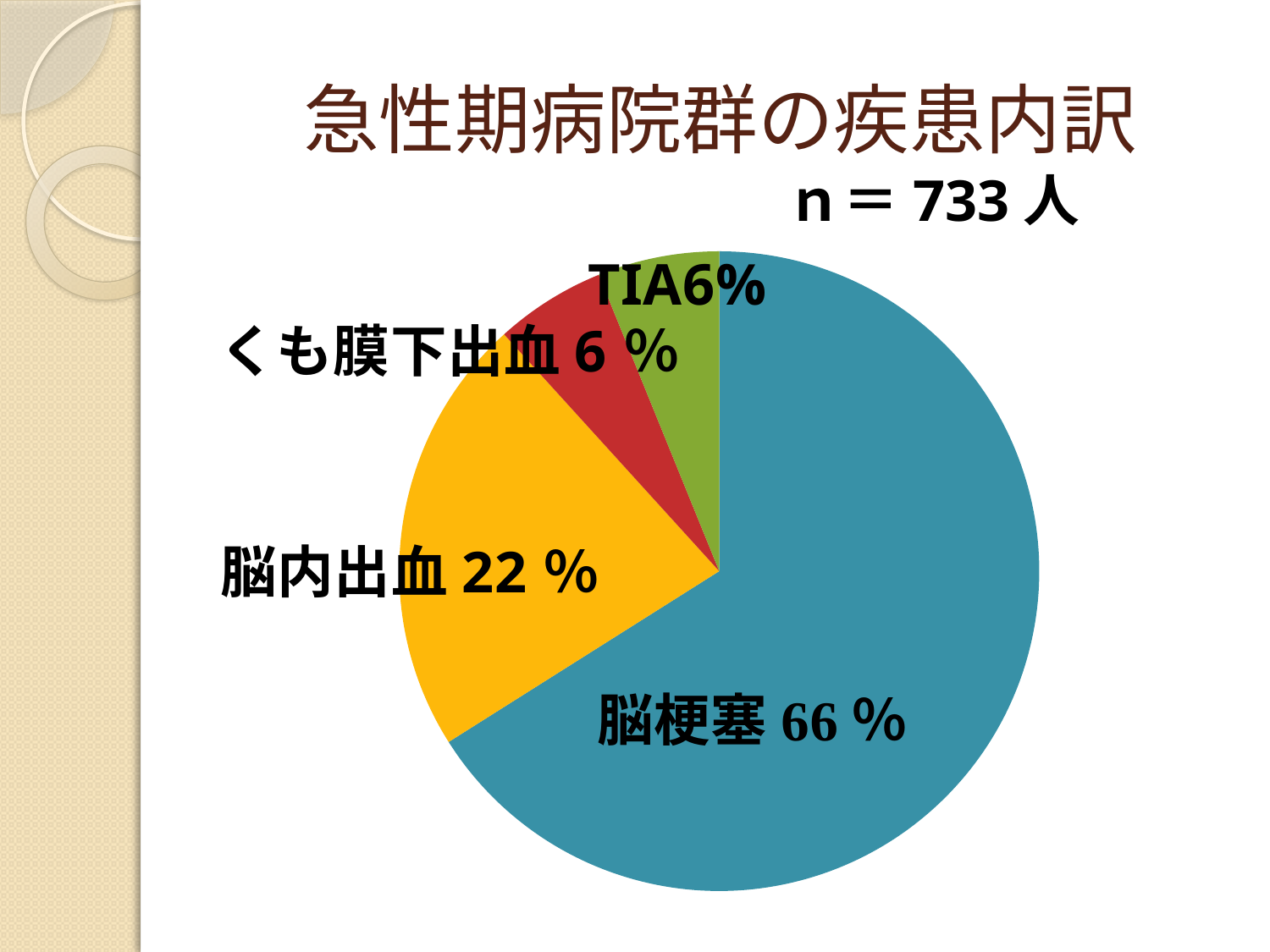
Which category has the largest slice of the pie? 脳梗塞 What share of the pie does くも膜下出血 represent? 6% What share of the pie does 脳内出血 represent? 22% What is the combined share of くも膜下出血 and TIA? 12% How many slices does the pie chart have? 4 What share of the pie does TIA represent? 6% Which is larger, the share for 脳内出血 or the share for くも膜下出血? 脳内出血 What is the sample size (n) shown on the slide? 733 人 What kind of chart is shown on the slide? pie chart What is the title of the chart on the slide? 急性期病院群の疾患内訳 What is the difference in percentage points between 脳梗塞 and 脳内出血? 44